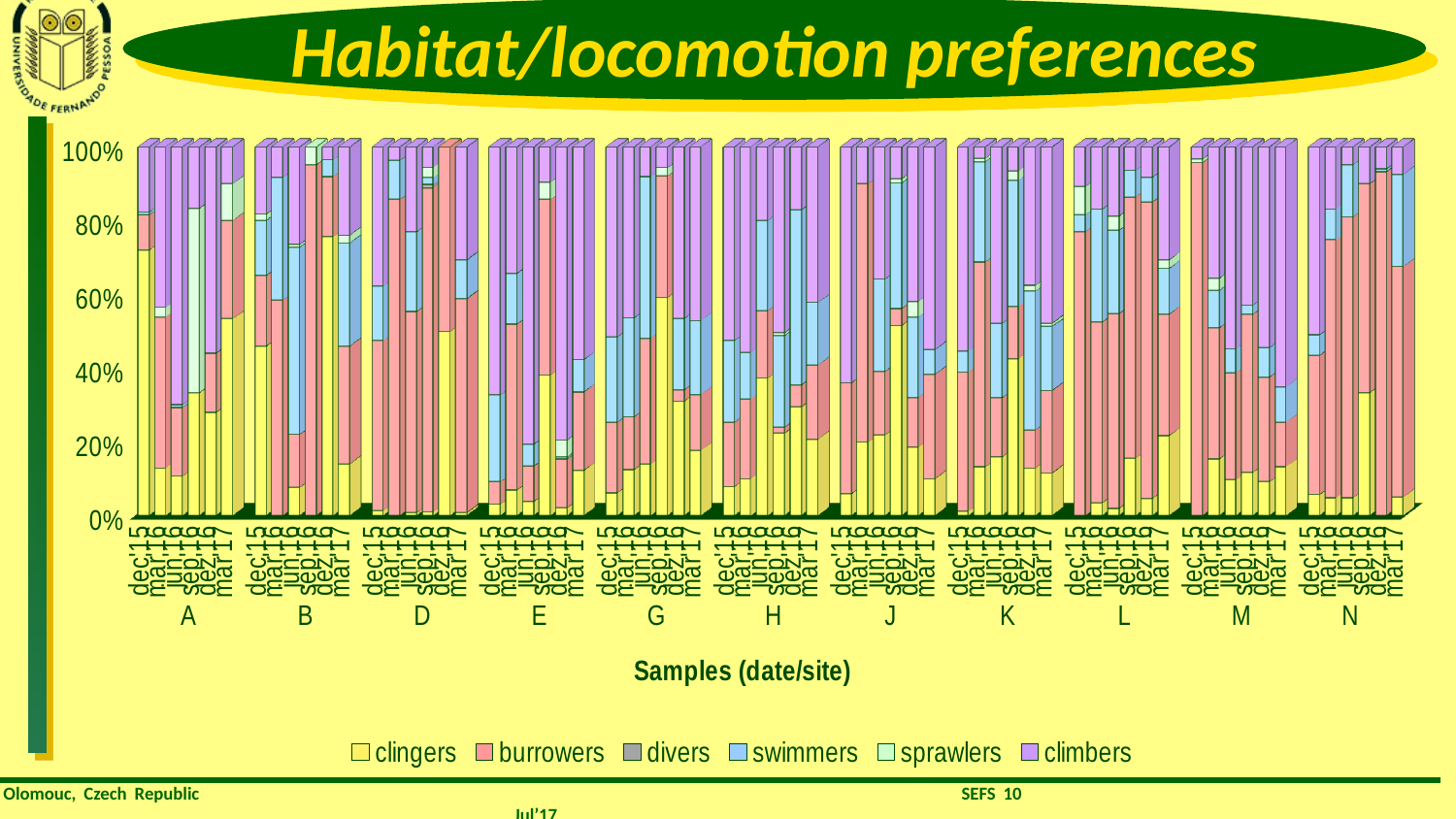
Is the clingers share for the dec'15 sample at site A greater or less than 60%? greater How many sample dates are plotted for each site? 6 What kind of chart is shown on the slide? Stacked bar chart Is the clingers share for the dec'15 sample at site B greater or less than 20%? greater How many sites are shown along the x axis? 11 Among the dec'15 samples, which site has the largest clingers share? A What is the title of the x axis? Samples (date/site) Which is larger: the clingers share for dec'15 at site A or the clingers share for dec'15 at site B? Site A Which series is listed first in the legend? clingers How many series does the legend list? 6 What does each stacked bar total? 100% Is the clingers share for the dec'15 sample at site D greater or less than 20%? less